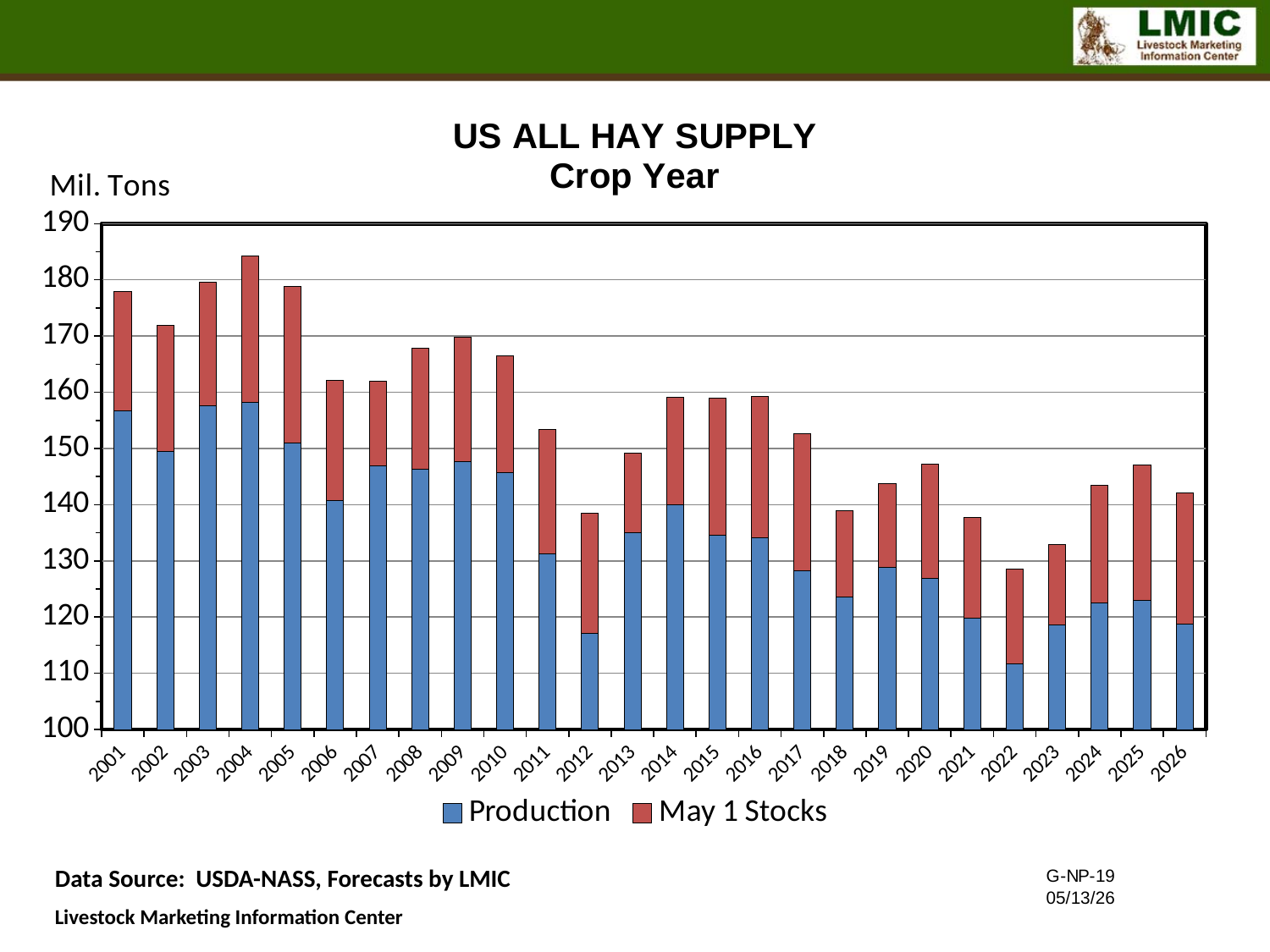
Which crop year has the larger total hay supply, 2016 or 2017? 2016 How many series does the legend list? 2 Is the total hay supply for 2004 greater or less than 180? greater Is the Production value for 2012 greater or less than 120? less What kind of chart is shown on the slide? stacked bar chart Overall, does the total hay supply rise or fall from 2001 to 2026? fall Which crop year has the lowest total hay supply? 2022 Which crop year has the lowest Production value? 2022 Which crop year has the highest total hay supply? 2004 What unit is shown on the y axis of the chart? Mil. Tons Is the total hay supply for 2009 greater or less than 180? less How many crop years are shown on the x axis? 26